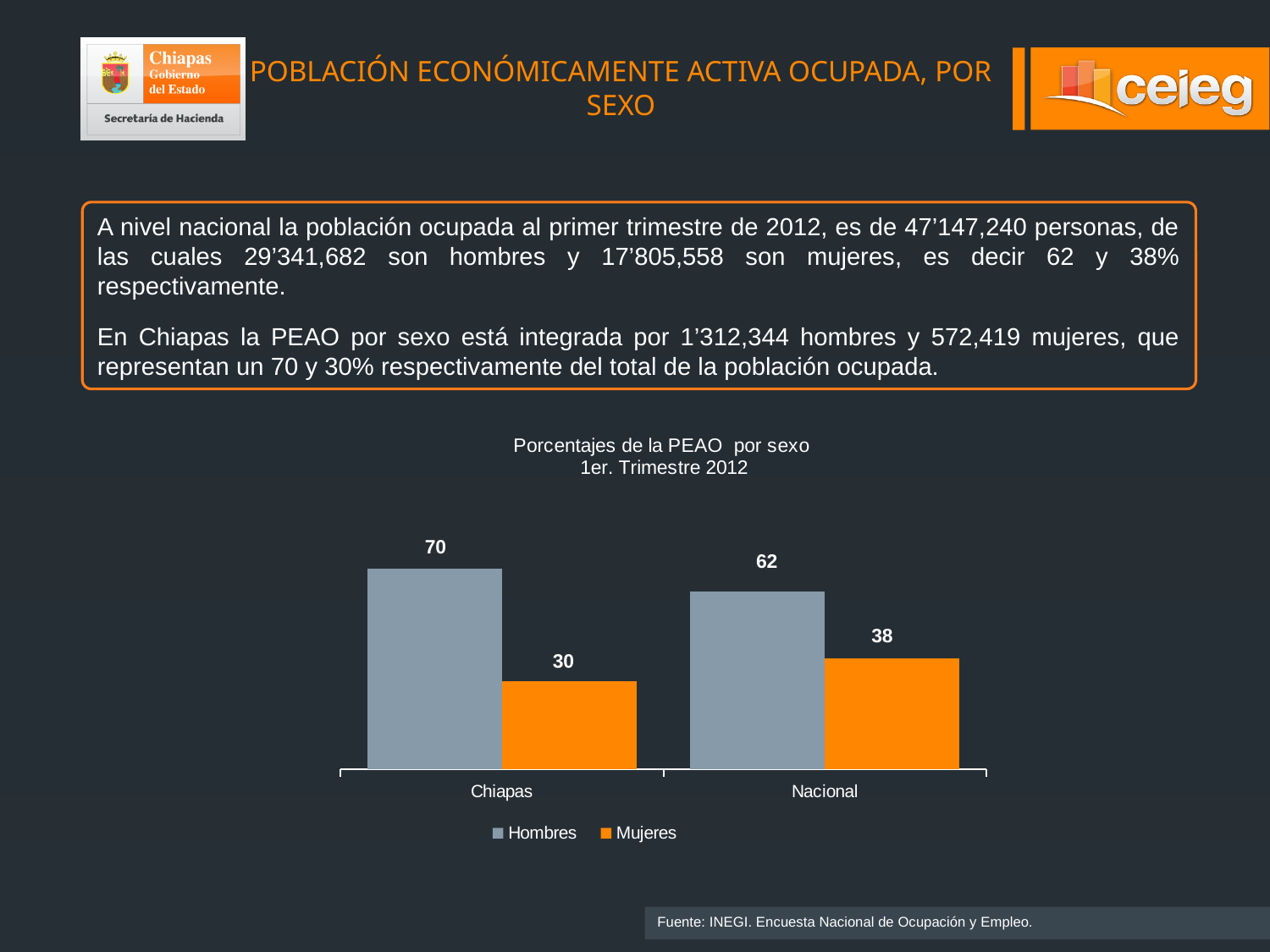
Which is larger, the Hombres value for Chiapas or the Hombres value for Nacional? Chiapas What is the value for Hombres in Chiapas? 70 What kind of chart is shown on the slide? Bar chart What is the difference between the Hombres and Mujeres values in Chiapas? 40 What is the value for Mujeres in Chiapas? 30 Which category has the highest value for Hombres? Chiapas How many categories are shown on the x axis? 2 What is the difference between the Mujeres values for Nacional and Chiapas? 8 Which category has the lowest value for Mujeres? Chiapas What is the value for Hombres in Nacional? 62 What is the value for Mujeres in Nacional? 38 How many series does the legend list? 2